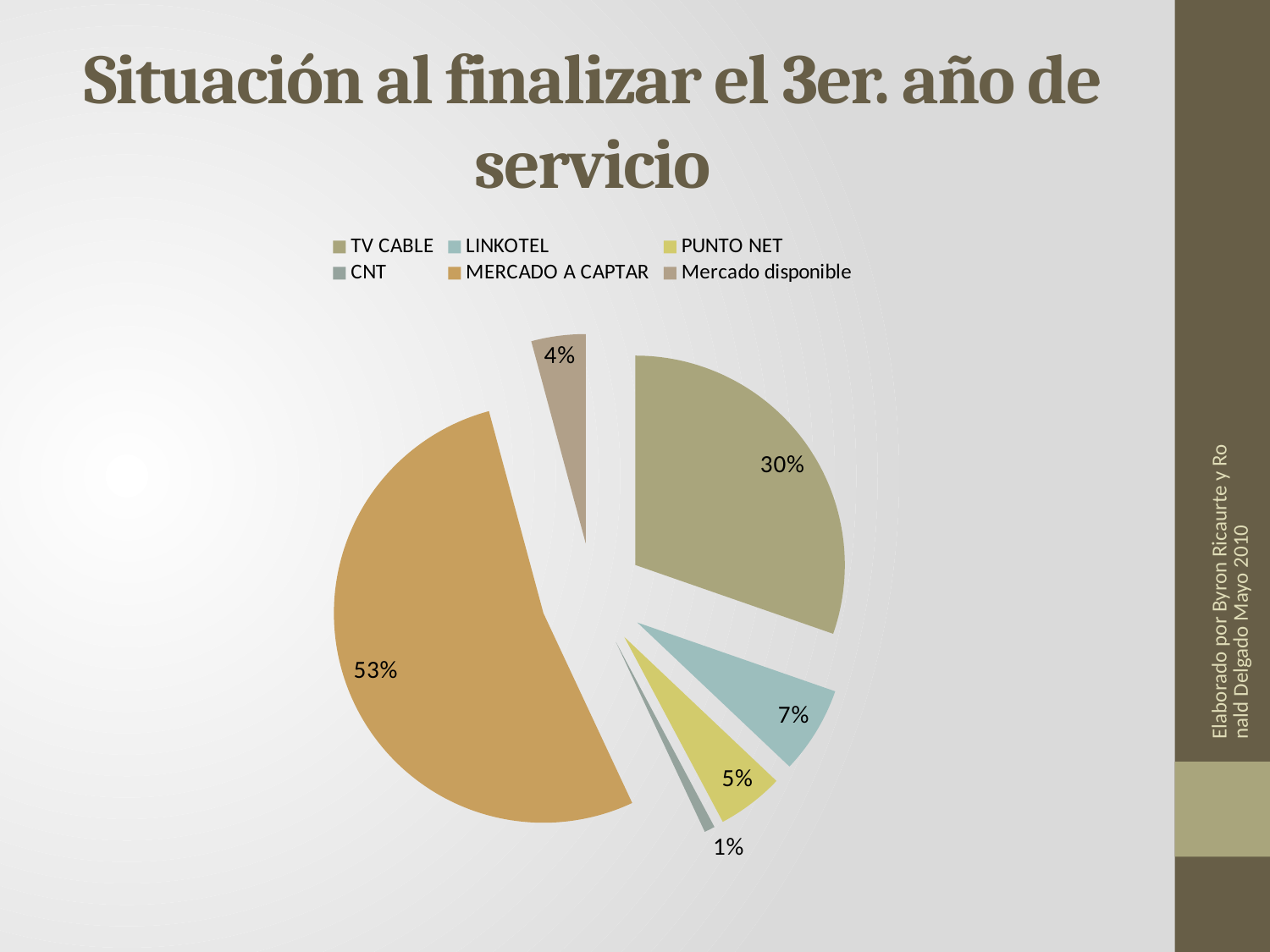
What share of the pie does Mercado disponible hold? 4% What is the difference in percentage points between MERCADO A CAPTAR and TV CABLE? 23 Which category has the smallest slice of the pie? CNT What share of the pie does MERCADO A CAPTAR hold? 53% Which category has the largest slice of the pie? MERCADO A CAPTAR What share of the pie does LINKOTEL hold? 7% What kind of chart is shown on the slide? pie chart Which is larger, the share for LINKOTEL or the share for PUNTO NET? LINKOTEL How many categories does the legend of the pie chart list? 6